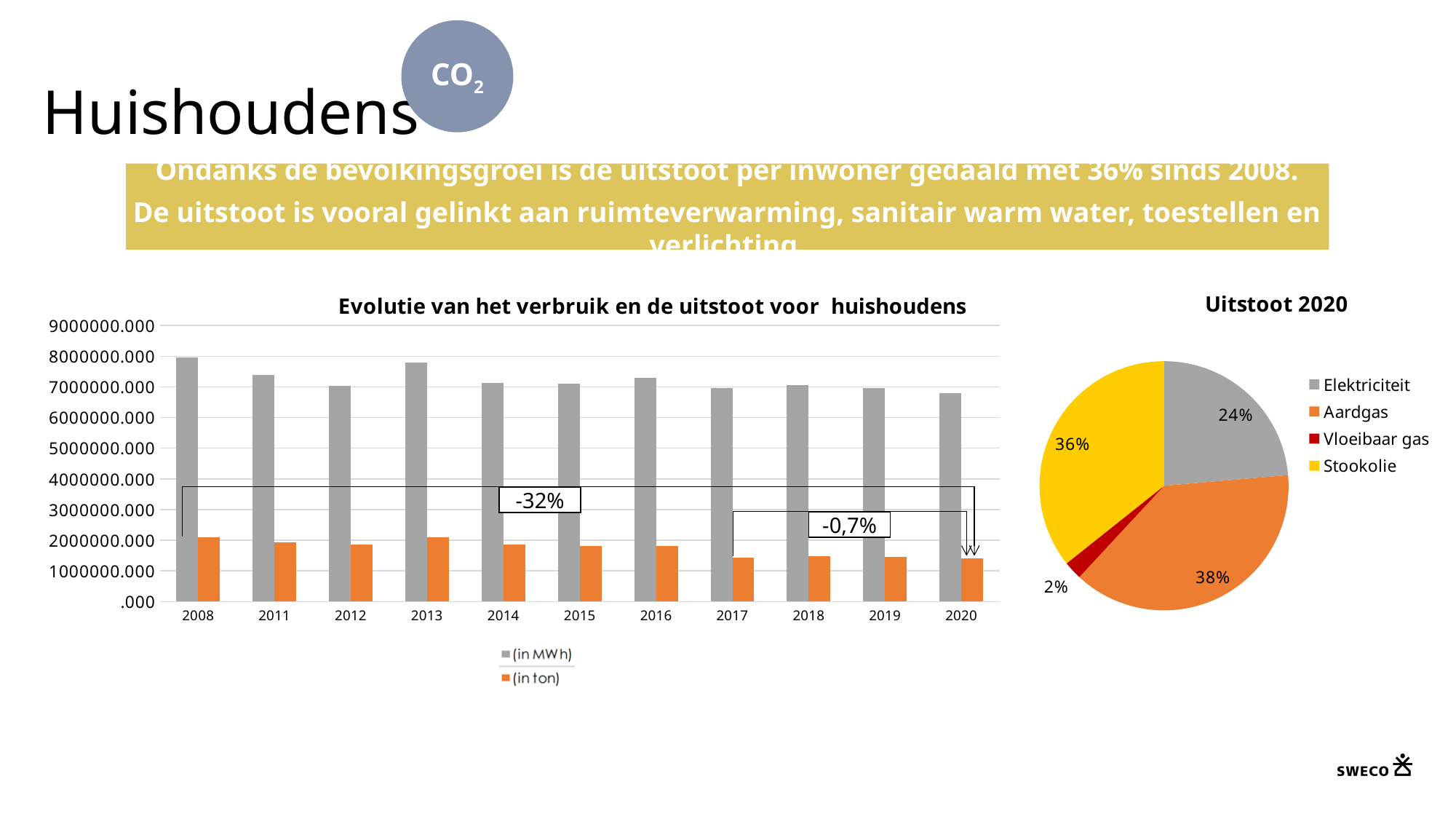
In the bar chart 'Evolutie van het verbruik en de uitstoot voor huishoudens', is the (in MWh) value for 2020 greater or less than 7000000.000? less In the bar chart 'Evolutie van het verbruik en de uitstoot voor huishoudens', how many series does the legend list? 2 In the pie chart 'Uitstoot 2020', how many percentage points larger is the Aardgas share than the Stookolie share? 2 percentage points In the bar chart 'Evolutie van het verbruik en de uitstoot voor huishoudens', which year has the highest value for (in MWh)? 2008 In the pie chart 'Uitstoot 2020', what share does Elektriciteit have? 24% In the bar chart 'Evolutie van het verbruik en de uitstoot voor huishoudens', how many years are shown on the x axis? 11 In the pie chart 'Uitstoot 2020', which category has the smallest share? Vloeibaar gas In the pie chart 'Uitstoot 2020', what share does Aardgas have? 38% In the pie chart 'Uitstoot 2020', which category has the largest share? Aardgas In the bar chart 'Evolutie van het verbruik en de uitstoot voor huishoudens', what percentage change is annotated between 2008 and 2020? -32% In the pie chart 'Uitstoot 2020', how many categories are shown? 4 In the pie chart 'Uitstoot 2020', what share does Stookolie have? 36%